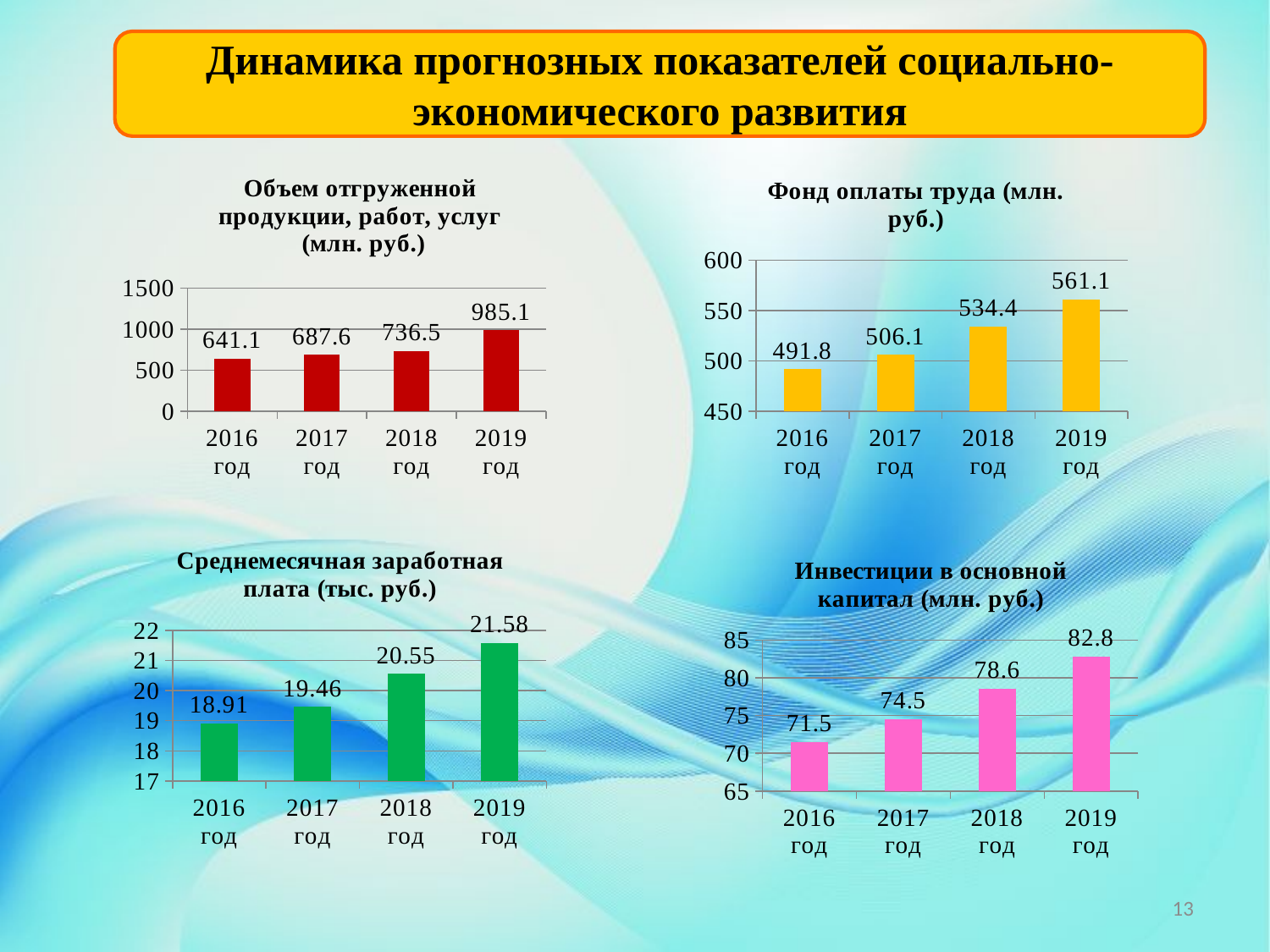
In the chart titled "Фонд оплаты труда (млн. руб.)", is the value for 2018 год larger than the value for 2017 год? Yes In the chart titled "Объем отгруженной продукции, работ, услуг (млн. руб.)", which year has the lowest value? 2016 год In the chart titled "Инвестиции в основной капитал (млн. руб.)", what is the value for 2018 год? 78.6 In the chart titled "Среднемесячная заработная плата (тыс. руб.)", what is the difference between the values for 2018 год and 2017 год? 1.09 In the chart titled "Инвестиции в основной капитал (млн. руб.)", what is the difference between the values for 2019 год and 2016 год? 11.3 What type of chart is the chart titled "Среднемесячная заработная плата (тыс. руб.)"? Bar chart In the chart titled "Объем отгруженной продукции, работ, услуг (млн. руб.)", do the values rise or fall from 2016 год to 2019 год? Rise In the chart titled "Объем отгруженной продукции, работ, услуг (млн. руб.)", what is the value for 2019 год? 985.1 In the chart titled "Фонд оплаты труда (млн. руб.)", which year has the highest value? 2019 год In the chart titled "Среднемесячная заработная плата (тыс. руб.)", what is the value for 2016 год? 18.91 In the chart titled "Фонд оплаты труда (млн. руб.)", what is the value for 2017 год? 506.1 How many years are shown in the chart titled "Инвестиции в основной капитал (млн. руб.)"? 4